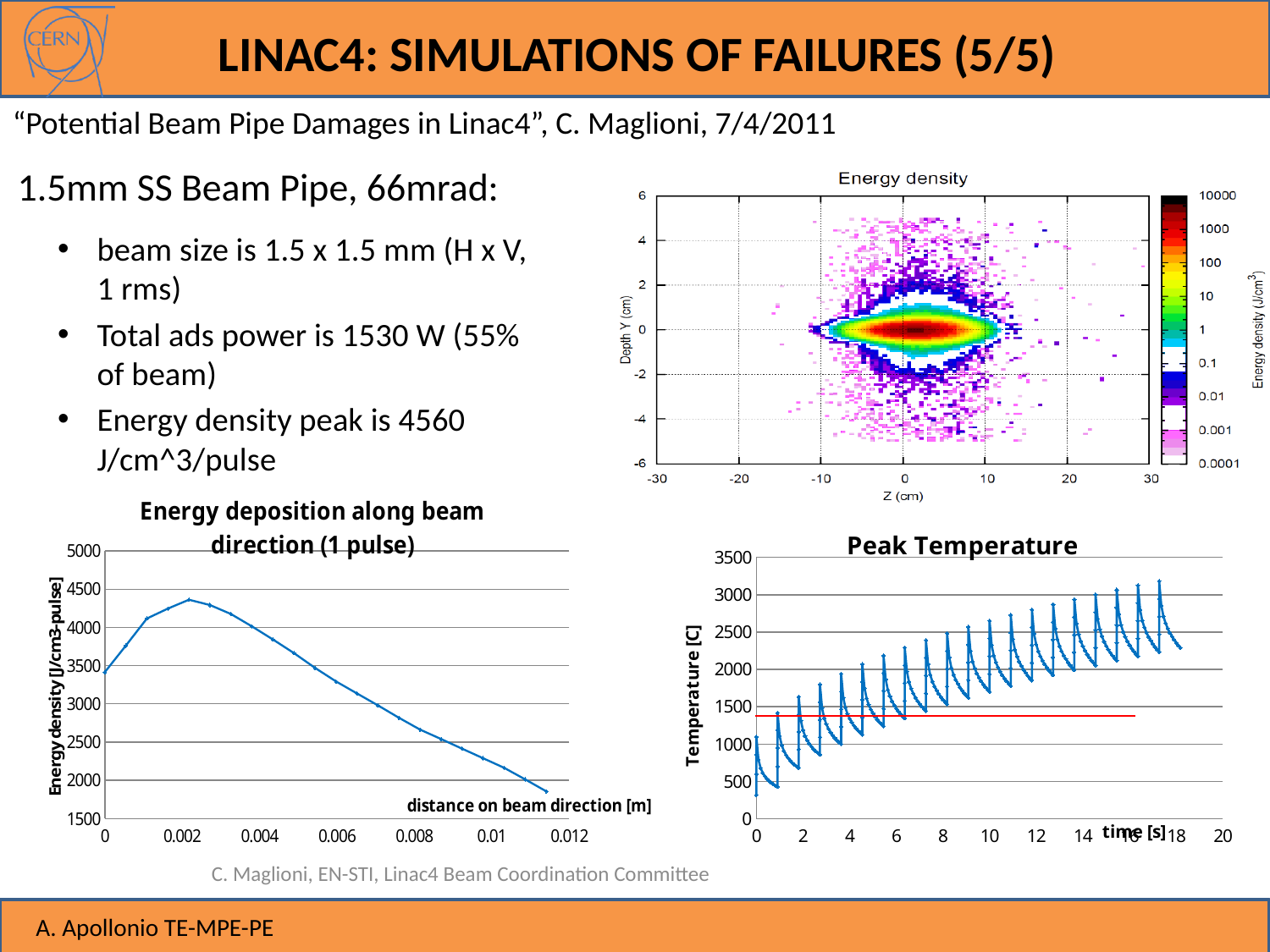
What is the x-axis label of the "Energy density" chart at the top right? Z (cm) In the "Energy deposition along beam direction (1 pulse)" chart, is the energy density at distance 0.01 m greater or less than 2500? less In the "Energy deposition along beam direction (1 pulse)" chart, is the peak energy density greater or less than 4000? greater In the "Energy deposition along beam direction (1 pulse)" chart, is the energy density at distance 0 greater or less than 3000? greater What is the y-axis label of the "Peak Temperature" chart? Temperature [C] What kind of chart is the "Peak Temperature" chart? line chart In the "Energy deposition along beam direction (1 pulse)" chart, does the energy density rise or fall between 0.004 m and 0.01 m? fall What kind of chart is the "Energy deposition along beam direction (1 pulse)" chart? line chart In the "Peak Temperature" chart, do the temperature peaks rise or fall over time? rise